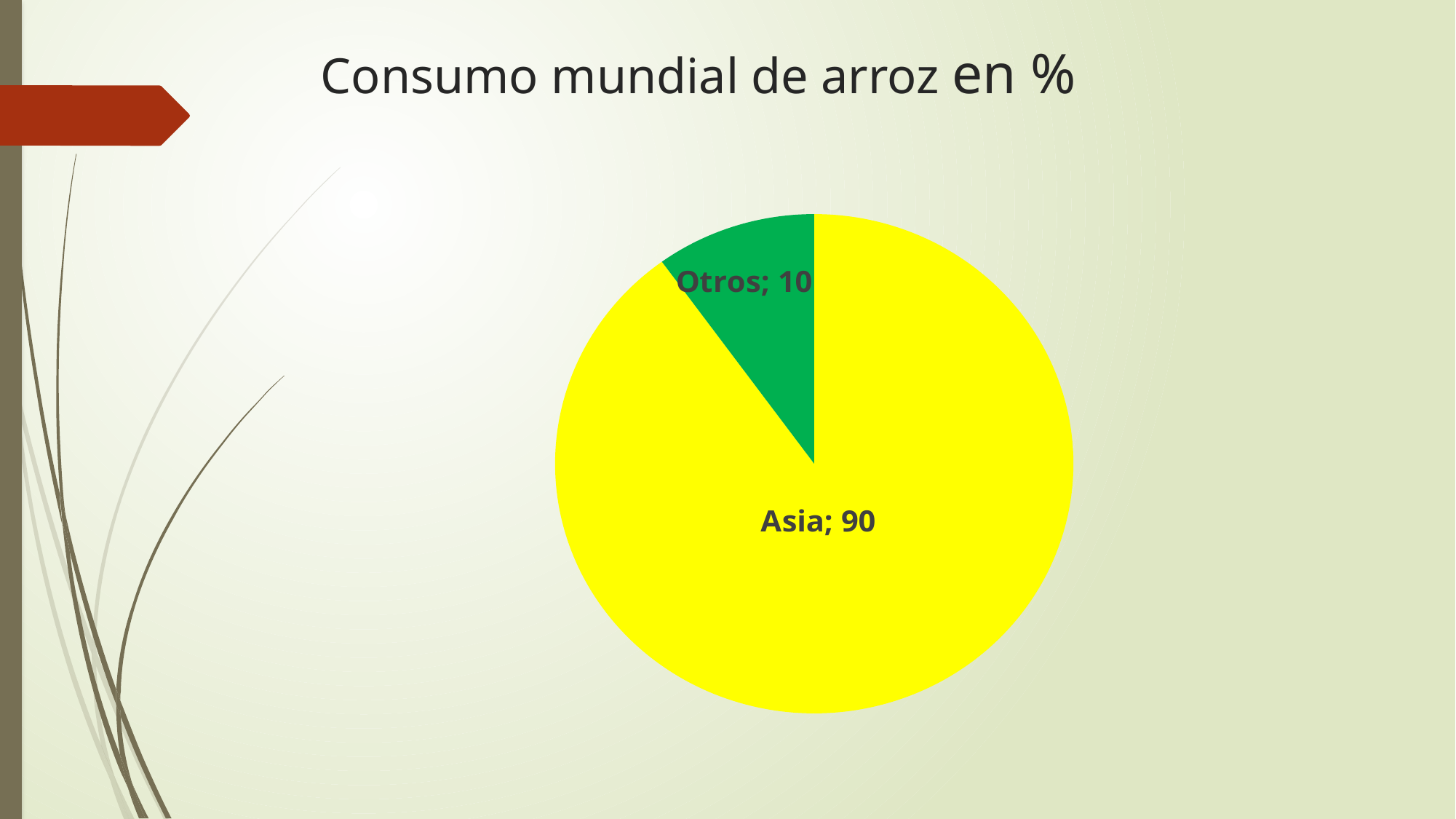
Which category has the largest slice? Asia What share of the pie does Otros represent? 10% What is the value for Otros? 10 What is the title of the slide? Consumo mundial de arroz en % What is the value for Asia? 90 How many slices does the pie chart have? 2 Which is larger, the value for Asia or the value for Otros? Asia What colour is the Asia slice? yellow What share of the pie does Asia represent? 90% Which category has the smallest slice? Otros What type of chart is shown on the slide? pie chart What is the difference between the values for Asia and Otros? 80